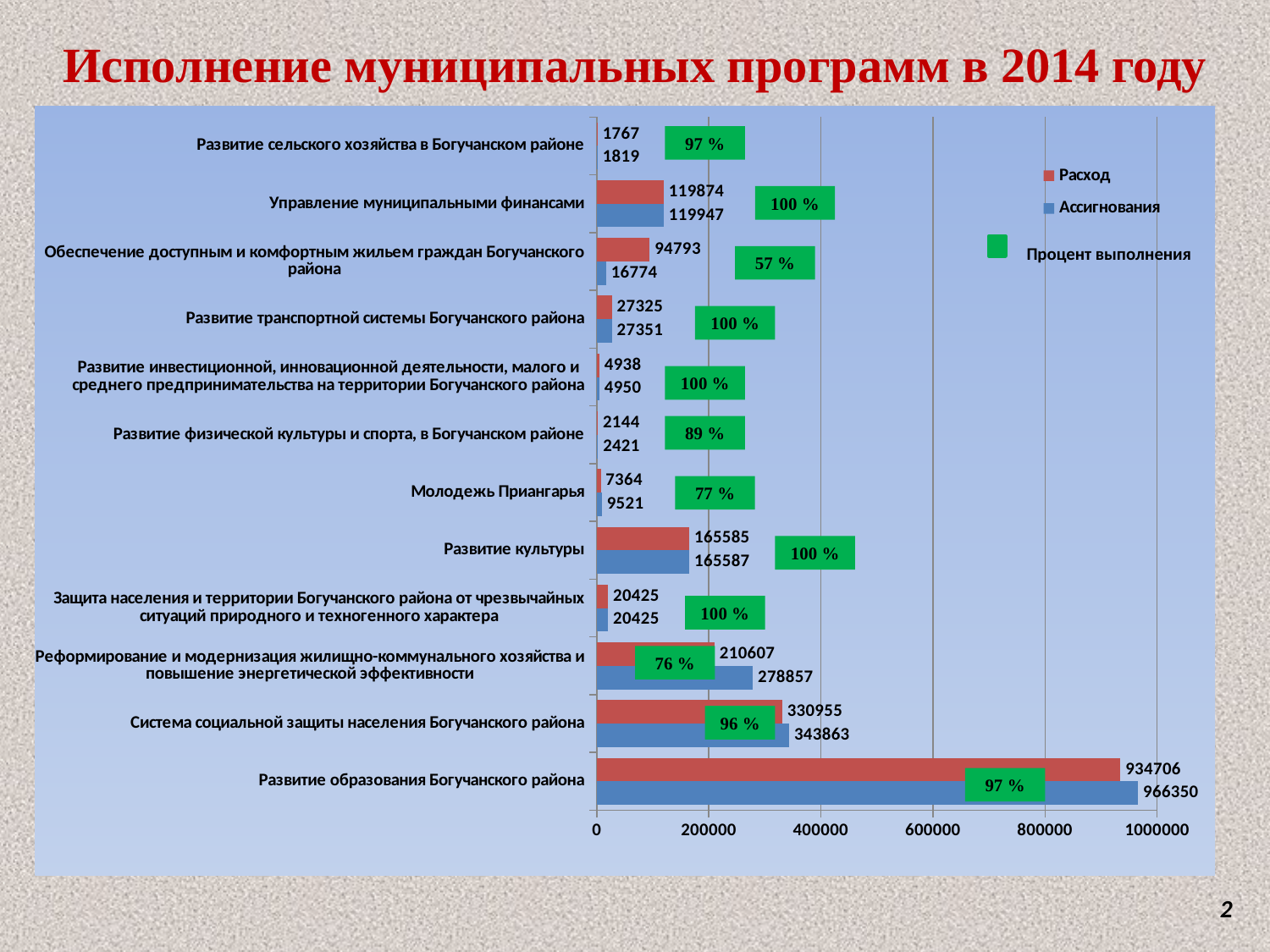
What is the difference between Ассигнования and Расход for Реформирование и модернизация жилищно-коммунального хозяйства и повышение энергетической эффективности? 68250 What is the Процент выполнения shown for Реформирование и модернизация жилищно-коммунального хозяйства и повышение энергетической эффективности? 76 % How many programs (categories) are shown on the chart? 12 Which program has the lowest Расход value? Развитие сельского хозяйства в Богучанском районе What kind of chart is shown on the slide? bar chart For Обеспечение доступным и комфортным жильем граждан Богучанского района, which is larger: Расход or Ассигнования? Расход Is the Ассигнования value for Развитие образования Богучанского района greater or less than 800000? greater What is the difference between Ассигнования and Расход for Развитие образования Богучанского района? 31644 What is the Расход value for Развитие образования Богучанского района? 934706 Which program has the highest Ассигнования value? Развитие образования Богучанского района How many entries does the chart legend list? 3 What is the Ассигнования value for Система социальной защиты населения Богучанского района? 343863